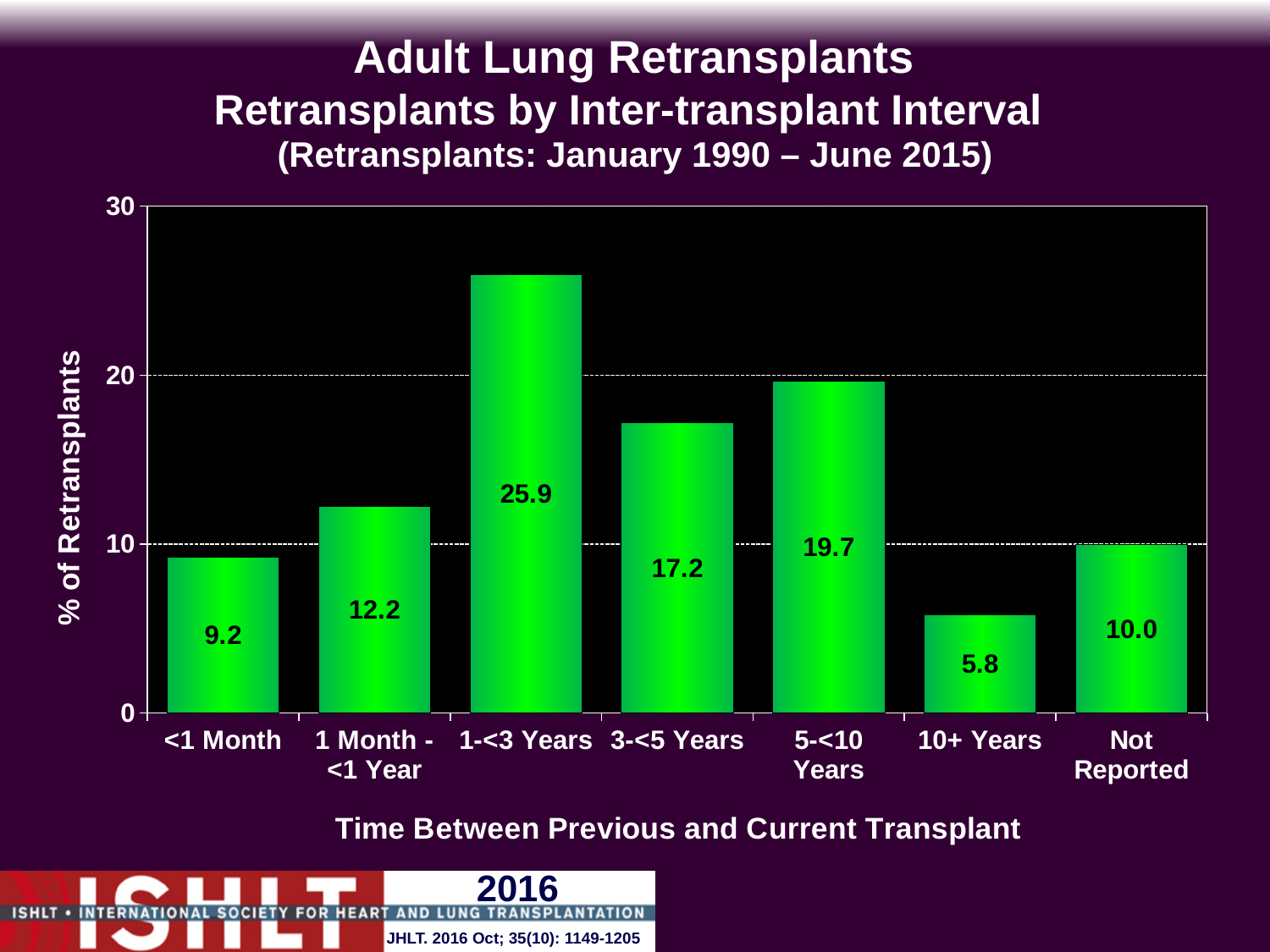
What is the label of the y axis? % of Retransplants How many categories are shown on the x axis? 7 Which category has the lowest percentage of retransplants? 10+ Years What is the value for the 10+ Years category? 5.8 Which inter-transplant interval category has the highest percentage of retransplants? 1-<3 Years What is the label of the x axis? Time Between Previous and Current Transplant What kind of chart is shown on the slide? bar chart Is the value for <1 Month greater or less than 10? less What is the difference between the values for 1-<3 Years and 3-<5 Years? 8.7 Which is larger, the value for 5-<10 Years or the value for 3-<5 Years? 5-<10 Years What percentage of retransplants had an inter-transplant interval of 1-<3 Years? 25.9 What percentage of retransplants is shown for the Not Reported category? 10.0